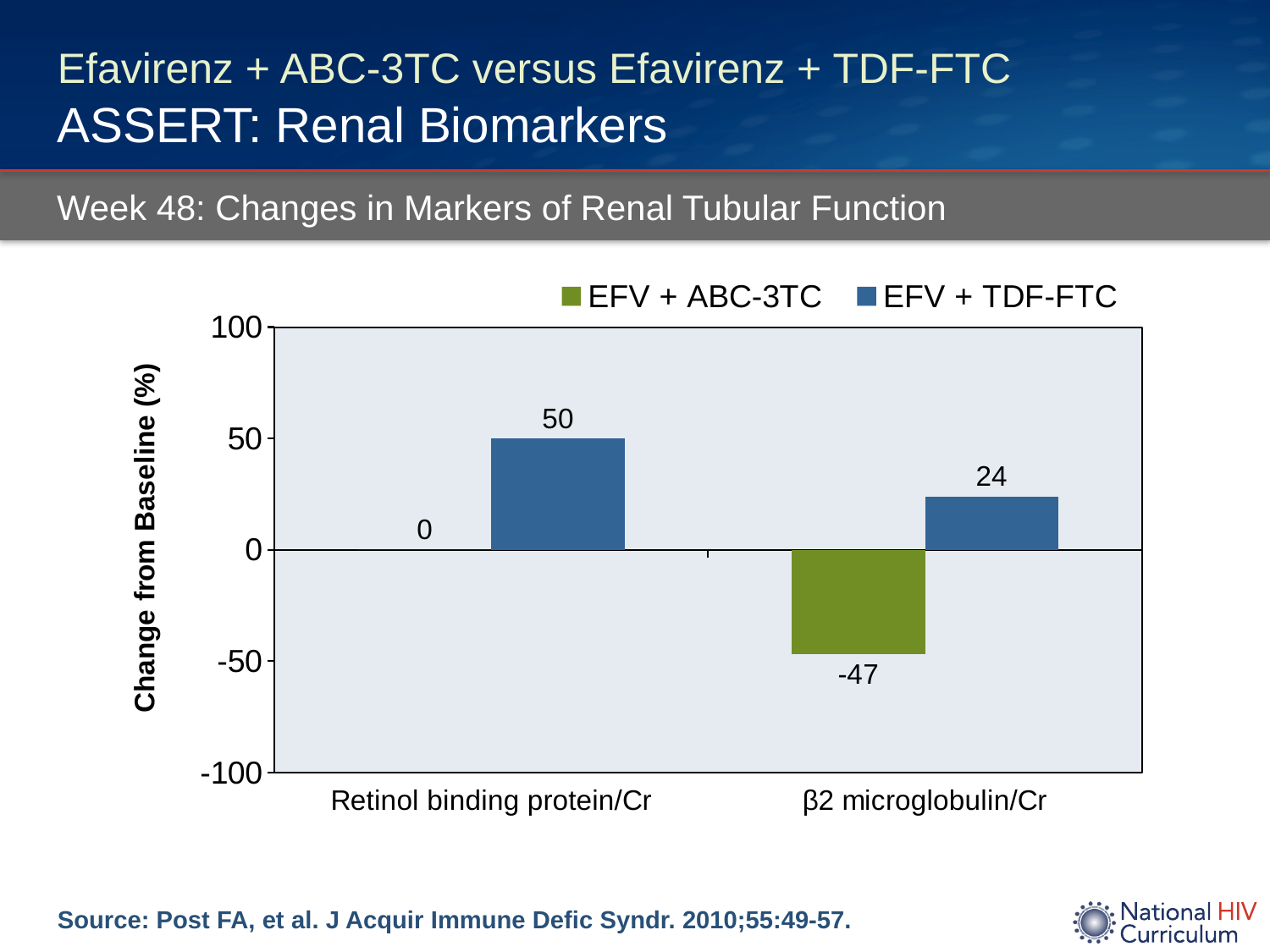
Which category has the lowest value for EFV + ABC-3TC? β2 microglobulin/Cr What is the change from baseline for EFV + TDF-FTC in Retinol binding protein/Cr? 50 For β2 microglobulin/Cr, which series has the larger value, EFV + ABC-3TC or EFV + TDF-FTC? EFV + TDF-FTC How many series does the legend list? 2 What is the change from baseline for EFV + ABC-3TC in β2 microglobulin/Cr? -47 What is the change from baseline for EFV + ABC-3TC in Retinol binding protein/Cr? 0 What is the label of the y axis? Change from Baseline (%) What kind of chart is shown on the slide? Bar chart How many categories are shown on the x axis? 2 Which category has the highest value for EFV + TDF-FTC? Retinol binding protein/Cr What is the difference between the EFV + TDF-FTC values for Retinol binding protein/Cr and β2 microglobulin/Cr? 26 What is the change from baseline for EFV + TDF-FTC in β2 microglobulin/Cr? 24